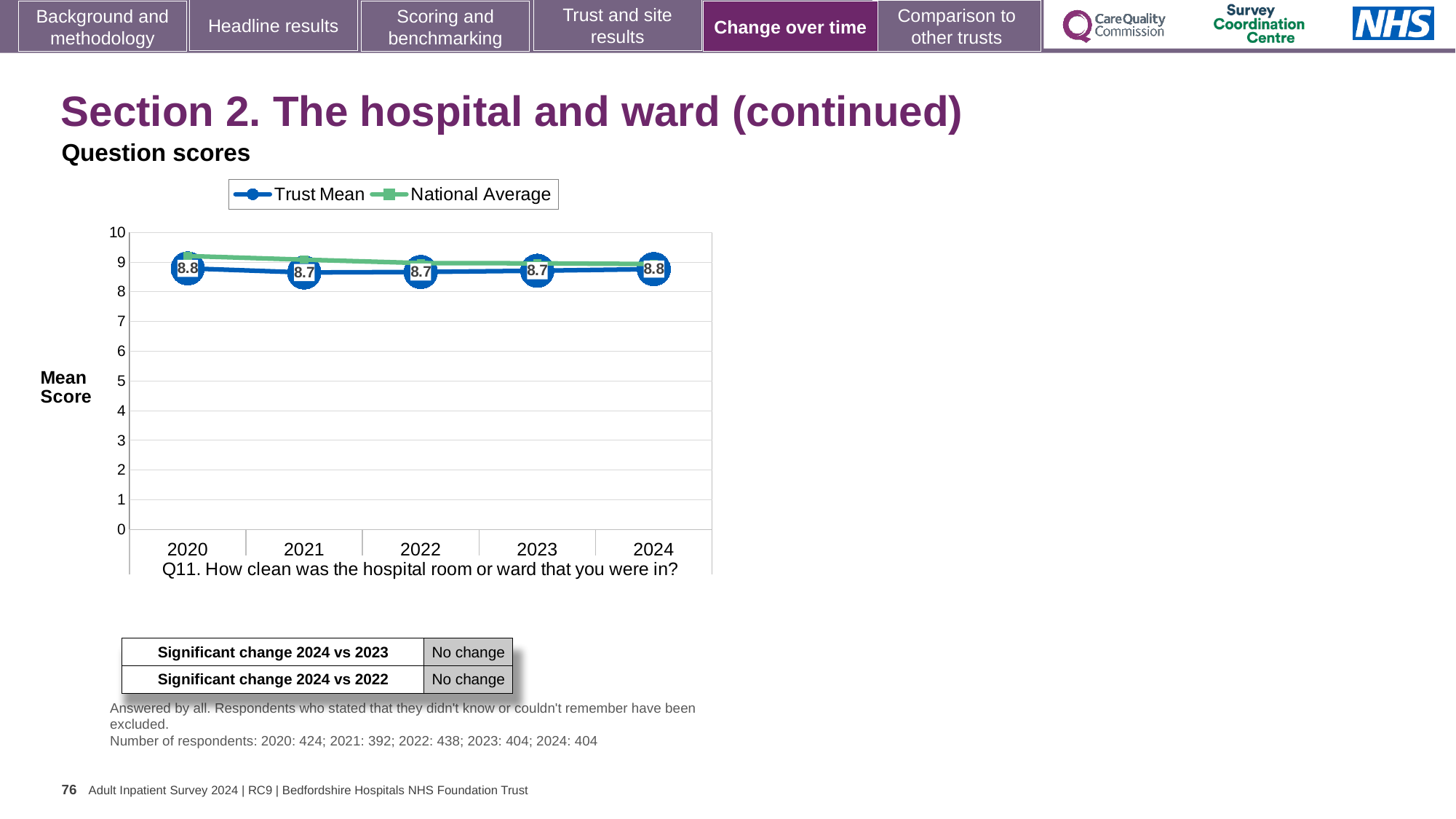
What is the difference between the Trust Mean in 2020 and in 2021? 0.1 What is the Trust Mean value for 2023? 8.7 Is the National Average value for 2020 greater or less than 5? greater What is the Trust Mean value for 2022? 8.7 What is the Trust Mean value for 2024? 8.8 What is the Trust Mean value for 2020? 8.8 Is the Trust Mean value for 2021 greater or less than 8? greater What kind of chart is shown? line chart In 2020, which is higher: the Trust Mean or the National Average? National Average How many series does the legend list? 2 How many years are plotted on the x axis? 5 What is the label on the y axis? Mean Score